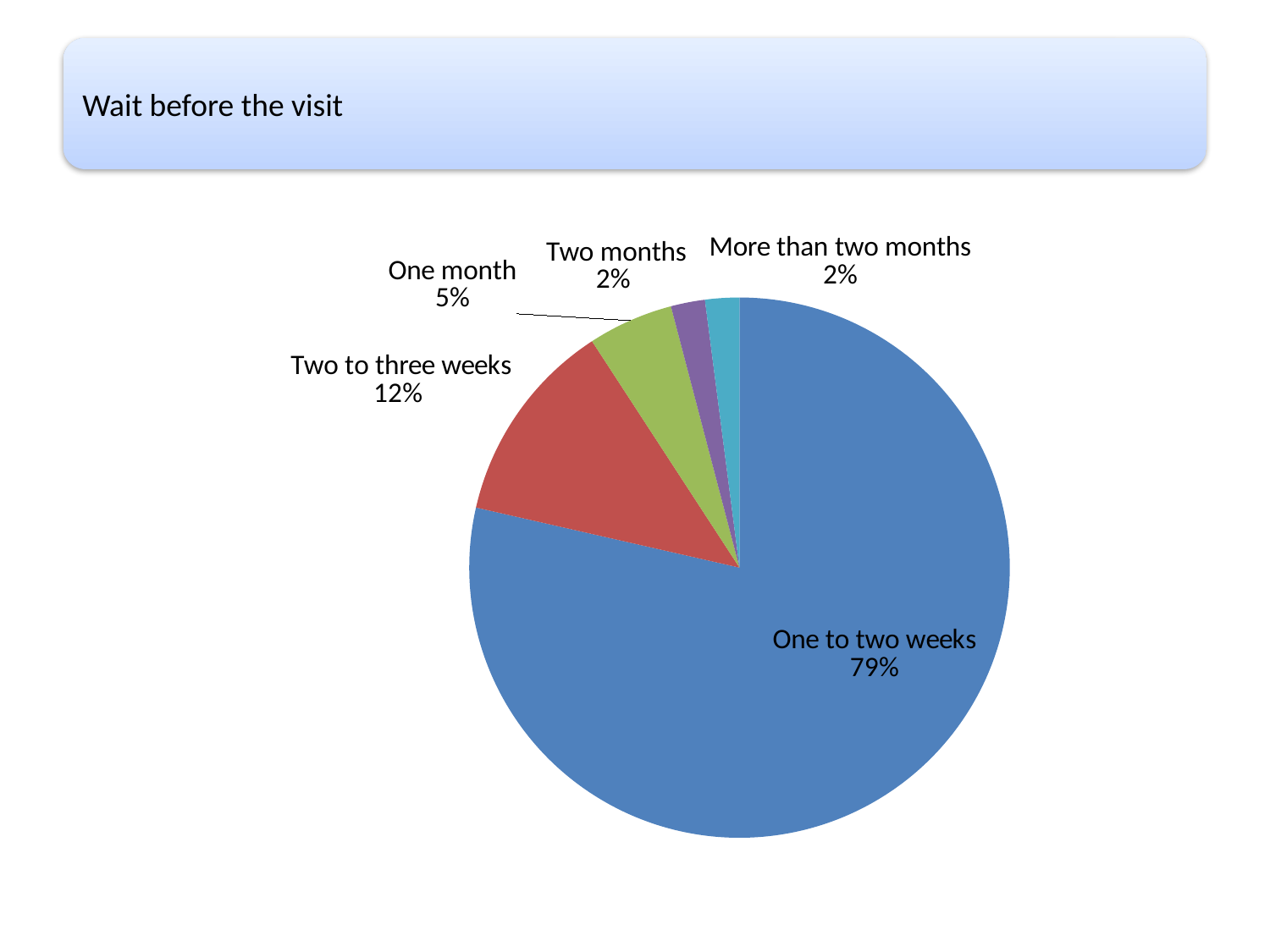
What share of the pie is 'More than two months'? 2% What is the difference in percentage points between 'One to two weeks' and 'Two to three weeks'? 67 What kind of chart is shown on the slide? Pie chart Which is larger, the share for 'Two to three weeks' or the share for 'One month'? Two to three weeks What is the title of the slide containing the pie chart? Wait before the visit Which category has the largest slice of the pie? One to two weeks What share of the pie is 'One month'? 5% What share of the pie is 'Two to three weeks'? 12% How many slices does the pie chart have? 5 What is the difference in percentage points between 'Two to three weeks' and 'One month'? 7